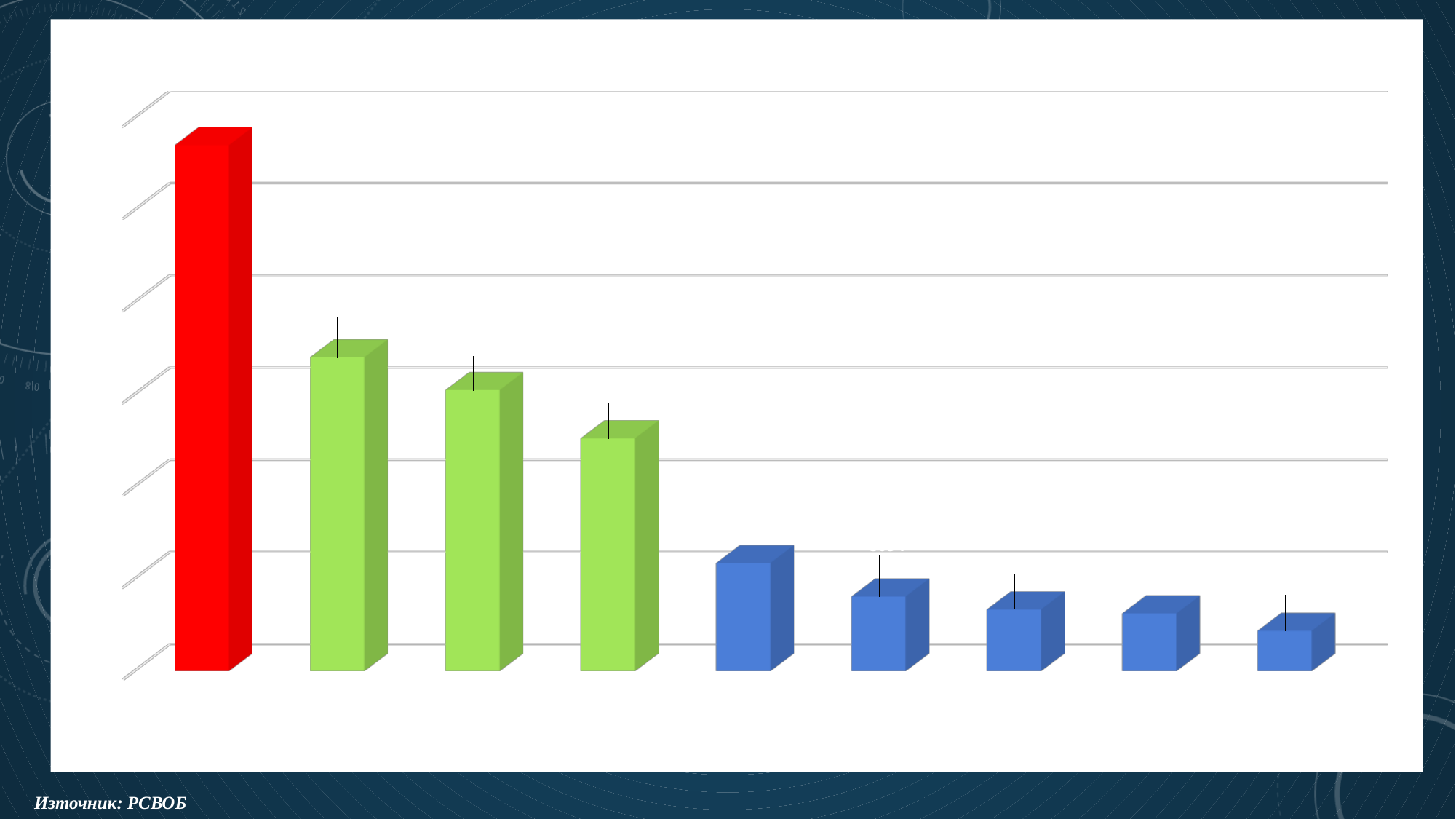
How many bars in the chart are coloured blue? 5 Which bar is the tallest in the chart? the first (red) bar on the left Do the bar values rise or fall from left to right across the chart? fall Which bar is the shortest in the chart? the last (rightmost) blue bar Which is taller, the fourth bar or the fifth bar? the fourth bar Which is taller, the first bar or the second bar? the first bar What colour is the tallest bar in the chart? red How many bars does the chart contain? 9 What kind of chart is shown on the slide? bar chart